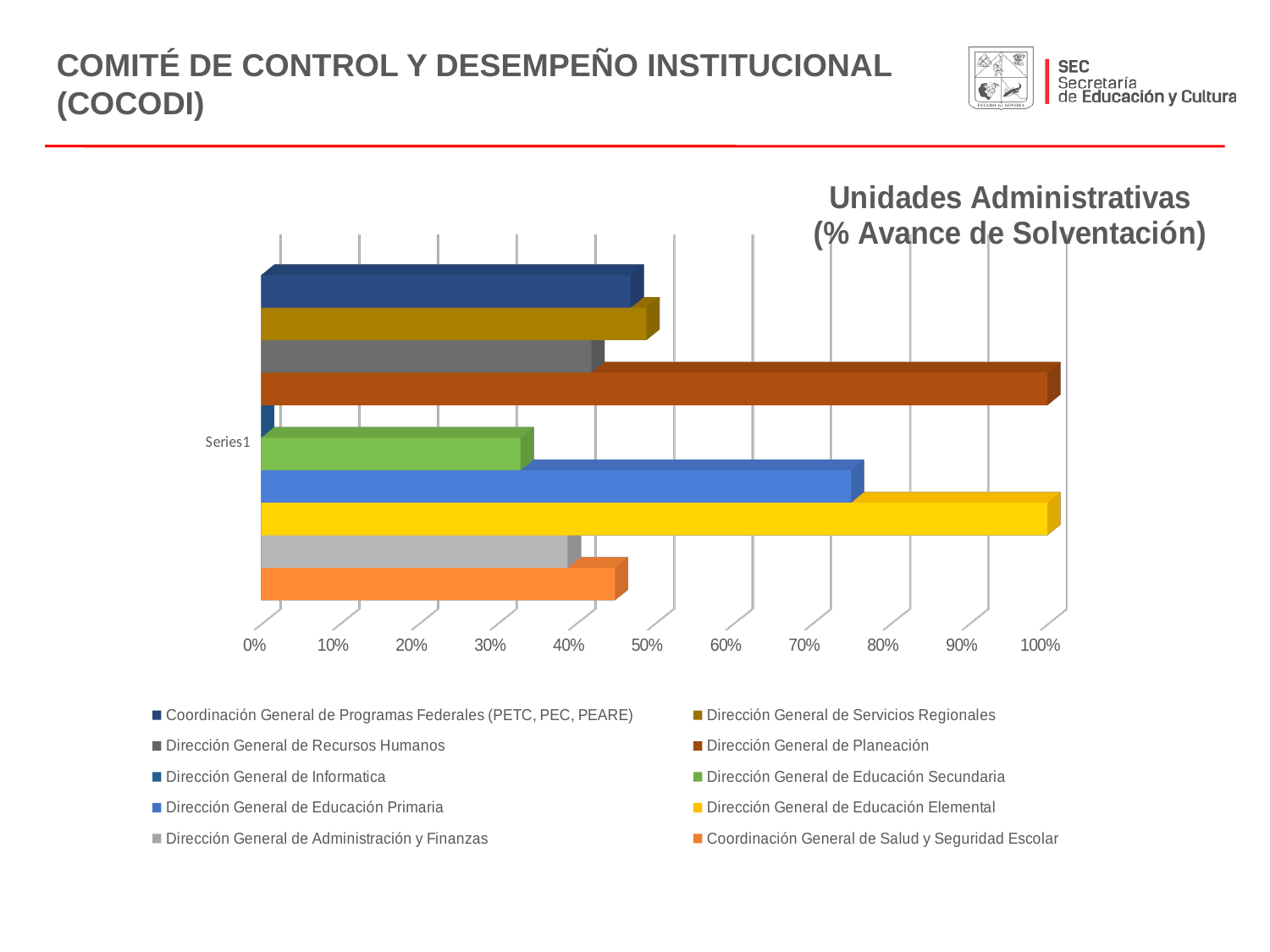
Is the value for Dirección General de Informatica greater or less than 10%? less What is the label shown on the vertical axis of the chart? Series1 Which is larger, the value for Dirección General de Planeación or for Dirección General de Recursos Humanos? Dirección General de Planeación Which series has the lowest value in the chart? Dirección General de Informatica What is the title of the chart? Unidades Administrativas (% Avance de Solventación) Is the value for Dirección General de Educación Primaria greater or less than 70%? greater Is the value for Dirección General de Planeación greater or less than 90%? greater What kind of chart is shown on the slide? bar chart How many series does the legend list? 10 Which is larger, the value for Dirección General de Educación Primaria or for Dirección General de Educación Secundaria? Dirección General de Educación Primaria